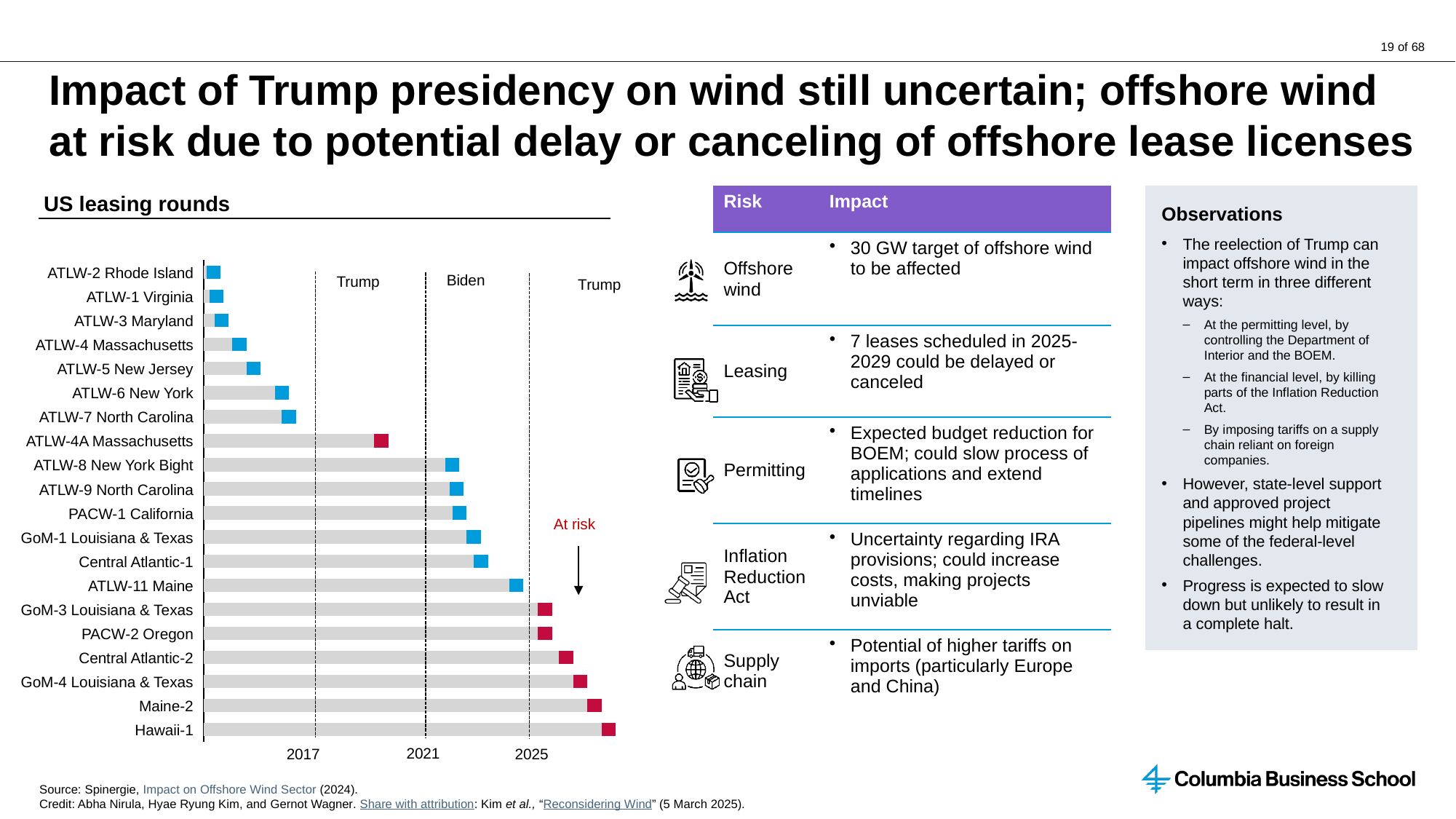
Which leasing round has the longest bar in the US leasing rounds chart? Hawaii-1 What are the three presidency labels shown between the dashed lines in the US leasing rounds chart? Trump, Biden, Trump Which leasing round has the shortest bar in the US leasing rounds chart? ATLW-2 Rhode Island How many leasing rounds are marked in red in the US leasing rounds chart? 7 In the US leasing rounds chart, which bar is longer: Hawaii-1 or ATLW-2 Rhode Island? Hawaii-1 Do the bars in the US leasing rounds chart get longer or shorter moving down the list from ATLW-2 Rhode Island to Hawaii-1? Longer What kind of chart is used to show the US leasing rounds? Bar chart What label is attached to the red markers in the US leasing rounds chart? At risk In the US leasing rounds chart, does the marker for ATLW-8 New York Bight fall before or after 2021? After In the US leasing rounds chart, does the marker for Hawaii-1 fall before or after 2025? After How many leasing rounds are listed on the y axis of the US leasing rounds chart? 20 In the US leasing rounds chart, does the marker for ATLW-4A Massachusetts fall before or after 2017? After